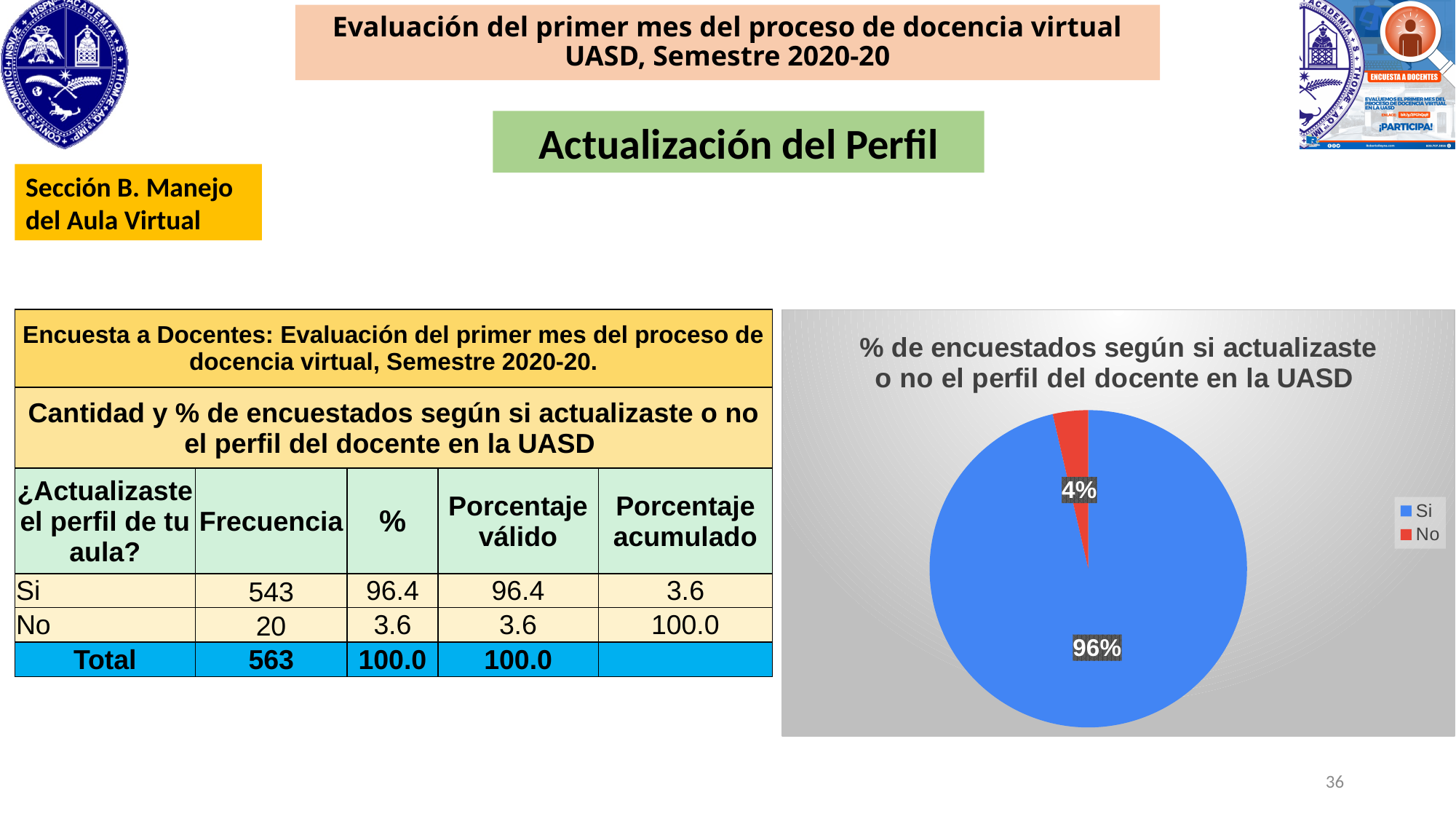
What is the title of the pie chart? % de encuestados según si actualizaste o no el perfil del docente en la UASD What colour is the "No" slice in the pie chart? red What percentage does the pie chart show for "Si"? 96% Which slice is larger in the pie chart, "Si" or "No"? Si How many slices does the pie chart have? 2 What percentage does the pie chart show for "No"? 4% What is the difference in percentage points between the "Si" and "No" slices in the pie chart? 92% Which category has the largest slice in the pie chart? Si What kind of chart is shown on the slide? pie chart How many entries does the legend of the pie chart list? 2 Which category has the smallest slice in the pie chart? No